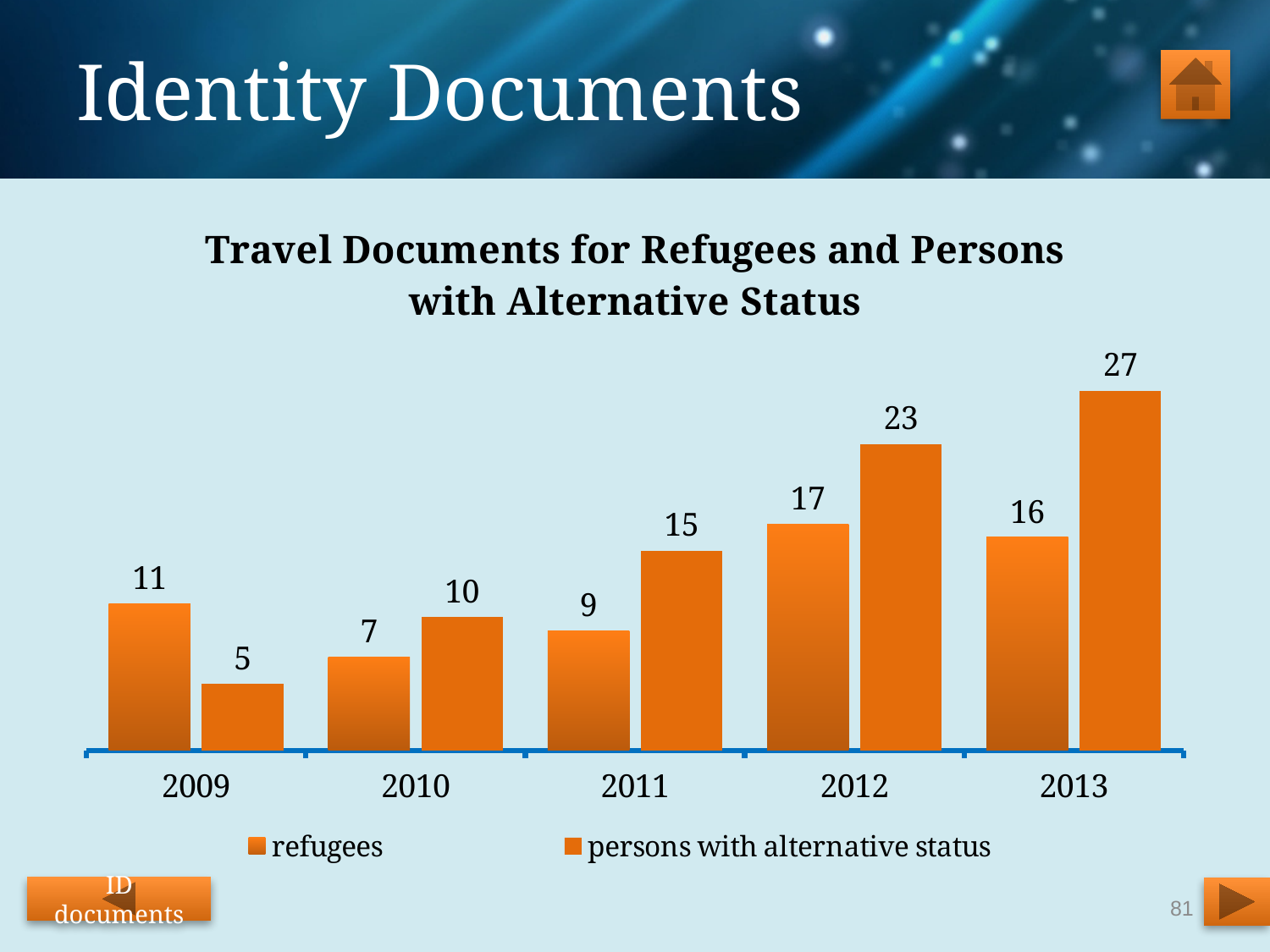
In which year is the value for refugees highest? 2012 Which is larger in 2010, the value for refugees or the value for persons with alternative status? persons with alternative status What kind of chart is shown on the slide? bar chart Does the value for persons with alternative status rise or fall from 2009 to 2013? rise What is the title of the chart? Travel Documents for Refugees and Persons with Alternative Status In which year is the value for persons with alternative status lowest? 2009 How many years are shown on the x axis? 5 What is the value for persons with alternative status in 2013? 27 What is the difference between persons with alternative status and refugees in 2012? 6 What is the value for refugees in 2009? 11 What is the value for persons with alternative status in 2011? 15 How many series does the legend list? 2